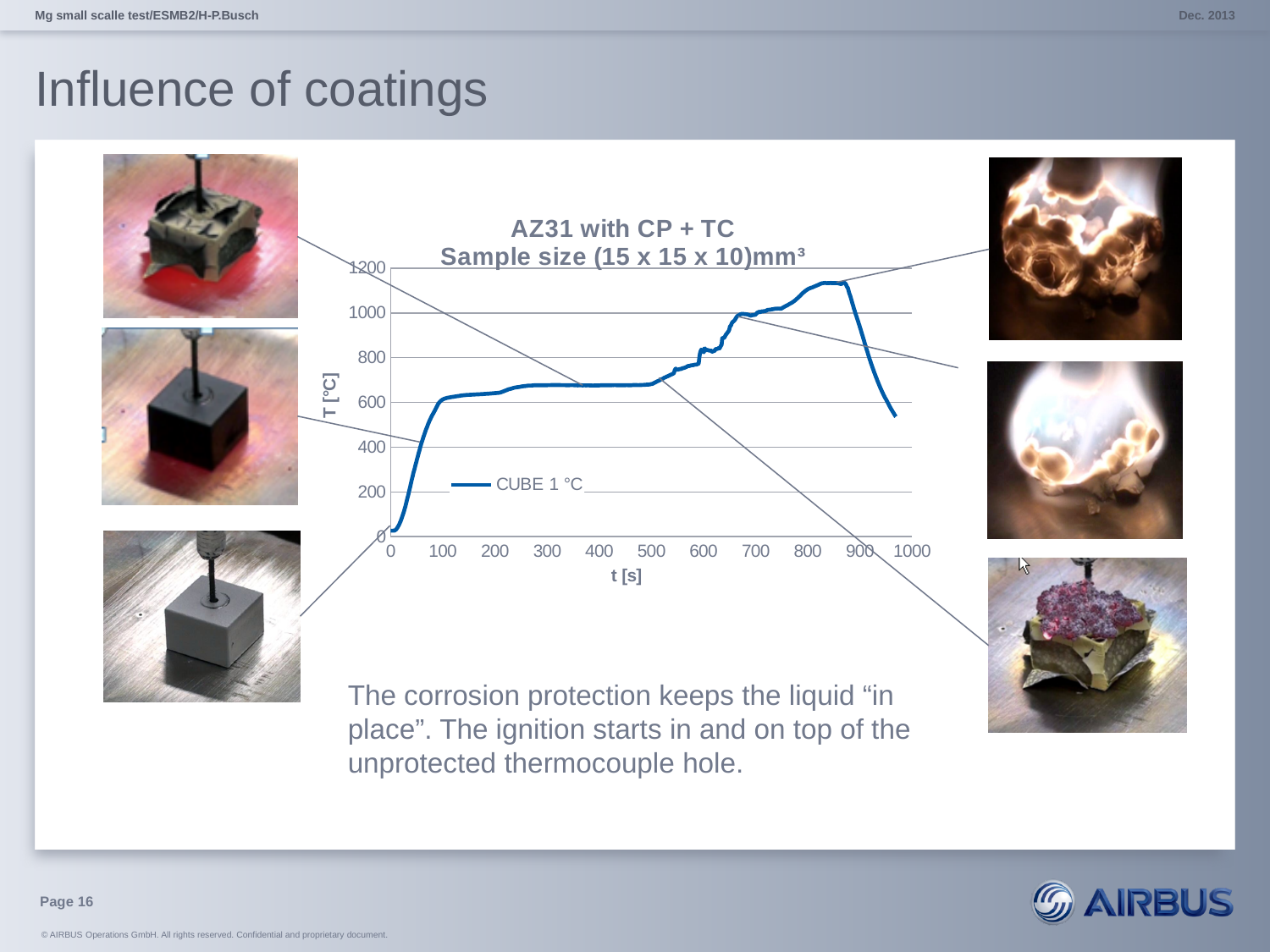
Is the temperature at t = 800 s greater or less than 1000 °C? greater What is the title of the chart? AZ31 with CP + TC Sample size (15 x 15 x 10)mm³ Does the temperature rise or fall between t = 900 s and t = 1000 s? fall What kind of chart is shown on the slide? line chart Is the temperature at t = 300 s greater or less than 600 °C? greater Does the temperature rise or fall between t = 0 s and t = 500 s? rise Is the temperature at t = 500 s greater or less than 600 °C? greater What is the name of the series shown in the chart legend? CUBE 1 °C How many series does the chart legend list? 1